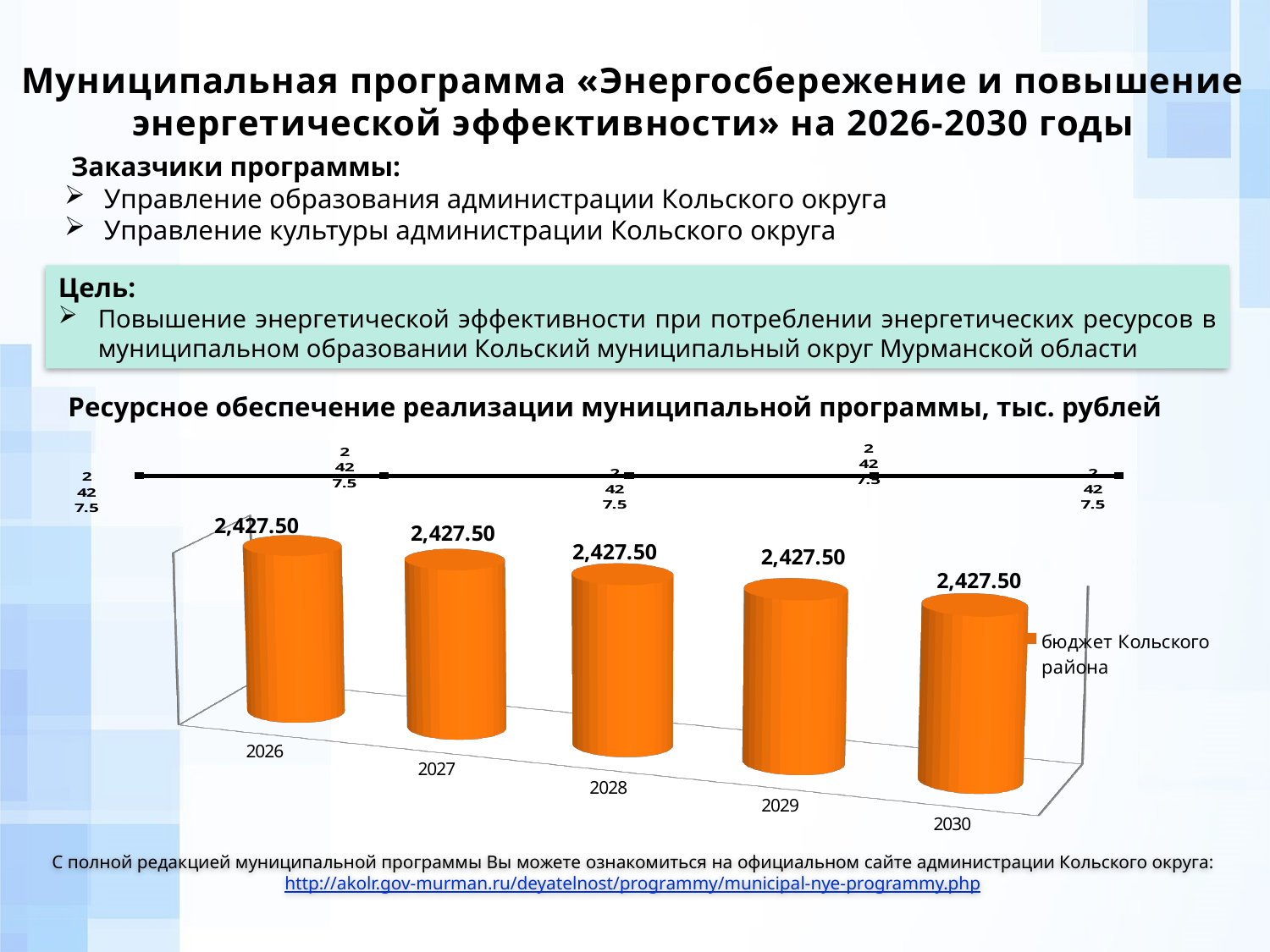
What kind of chart is used to show the resource provision by year? bar chart What is the difference between the values for 2026 and 2030? 0.00 What is the value for 2030 in the chart? 2,427.50 How many years (categories) are shown on the x axis of the chart? 5 Is the value for 2027 larger than, smaller than, or equal to the value for 2029? equal What is the value for 2026 in the chart 'Ресурсное обеспечение реализации муниципальной программы, тыс. рублей'? 2,427.50 Do the values rise, fall or stay the same from 2026 to 2030? stay the same What is the first year shown on the x axis of the chart? 2026 What does the legend entry of the chart say? бюджет Кольского района What is the value for 2029 in the chart? 2,427.50 What is the value for 2028 in the chart? 2,427.50